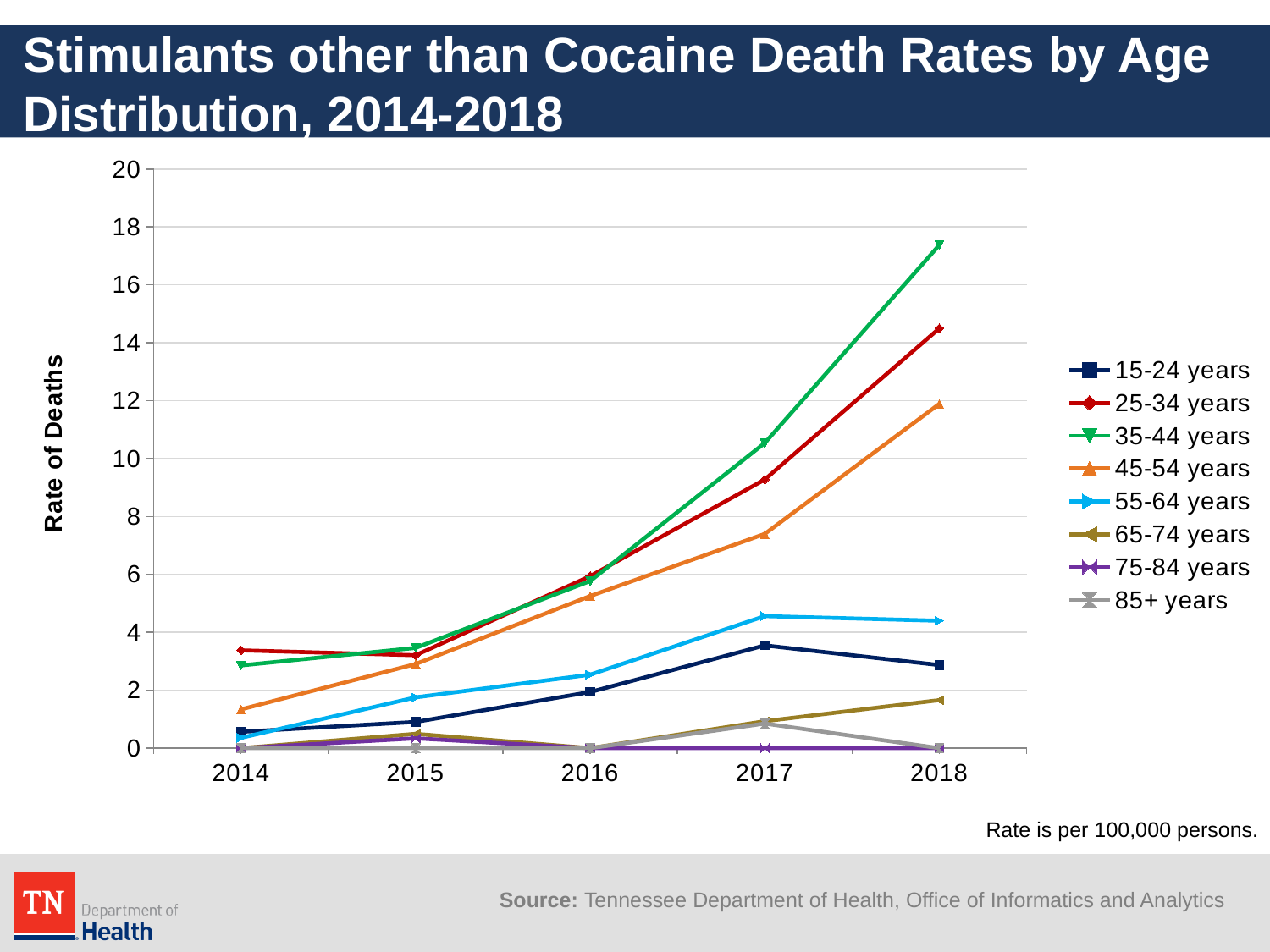
Does the death rate for 15-24 years rise or fall from 2017 to 2018? fall Is the value for 45-54 years in 2017 greater or less than 8? less How many years are plotted along the x axis? 5 In 2017, which is larger: the value for 15-24 years or the value for 55-64 years? 55-64 years Is the value for 35-44 years in 2018 greater or less than 16? greater Which age group has the highest death rate in 2018? 35-44 years What is the title of the y axis? Rate of Deaths In 2018, which is larger: the value for 45-54 years or the value for 55-64 years? 45-54 years What kind of chart is shown on the slide? line chart Is the value for 25-34 years in 2018 greater or less than 12? greater How many series does the legend list? 8 Does the death rate for 35-44 years rise or fall from 2014 to 2018? rise